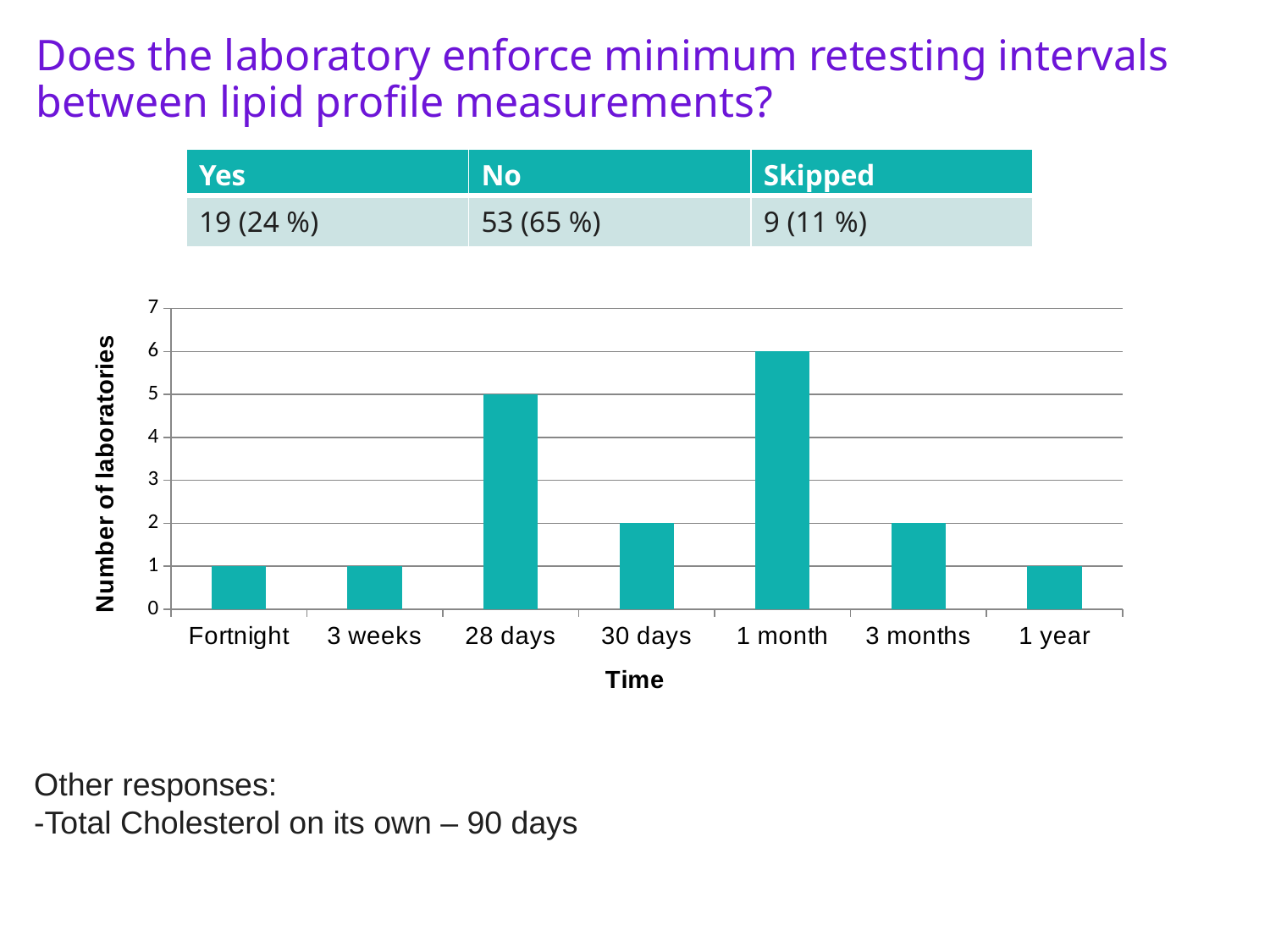
What is the difference in the number of laboratories between 1 month and 28 days? 1 What kind of chart is shown on the slide? Bar chart Which has more laboratories, 28 days or 30 days? 28 days What is the label of the y axis of the chart? Number of laboratories How many laboratories reported a minimum retesting interval of 3 months? 2 Which time interval has the highest number of laboratories? 1 month How many time intervals are shown on the x axis of the chart? 7 How many laboratories reported a minimum retesting interval of 28 days? 5 What is the label of the x axis of the chart? Time How many laboratories reported a minimum retesting interval of 1 month? 6 How many laboratories reported a minimum retesting interval of 1 year? 1 What is the difference in the number of laboratories between 30 days and Fortnight? 1